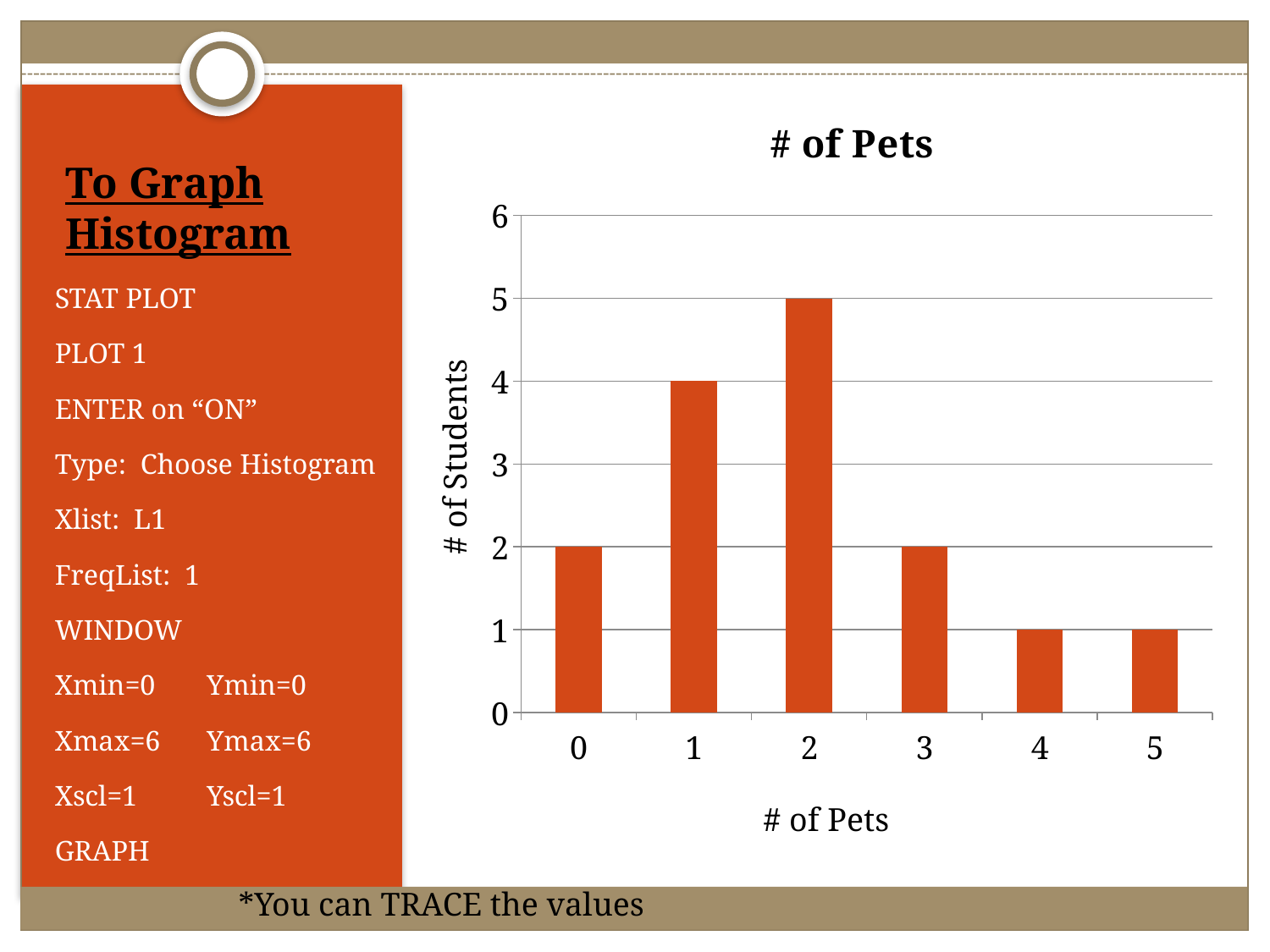
What is the label of the y axis? # of Students Which number of pets has the highest number of students? 2 How many categories (numbers of pets) are shown on the x axis? 6 Is the number of students with 1 pet greater or less than 3? greater What is the title of the chart? # of Pets How many students have 0 pets? 2 How many students have 2 pets? 5 What is the difference between the number of students with 2 pets and the number with 1 pet? 1 How many students have 1 pet? 4 Which has more students: 3 pets or 4 pets? 3 pets What kind of chart is shown on the slide? bar chart Do the bars rise or fall from 2 pets to 5 pets? fall